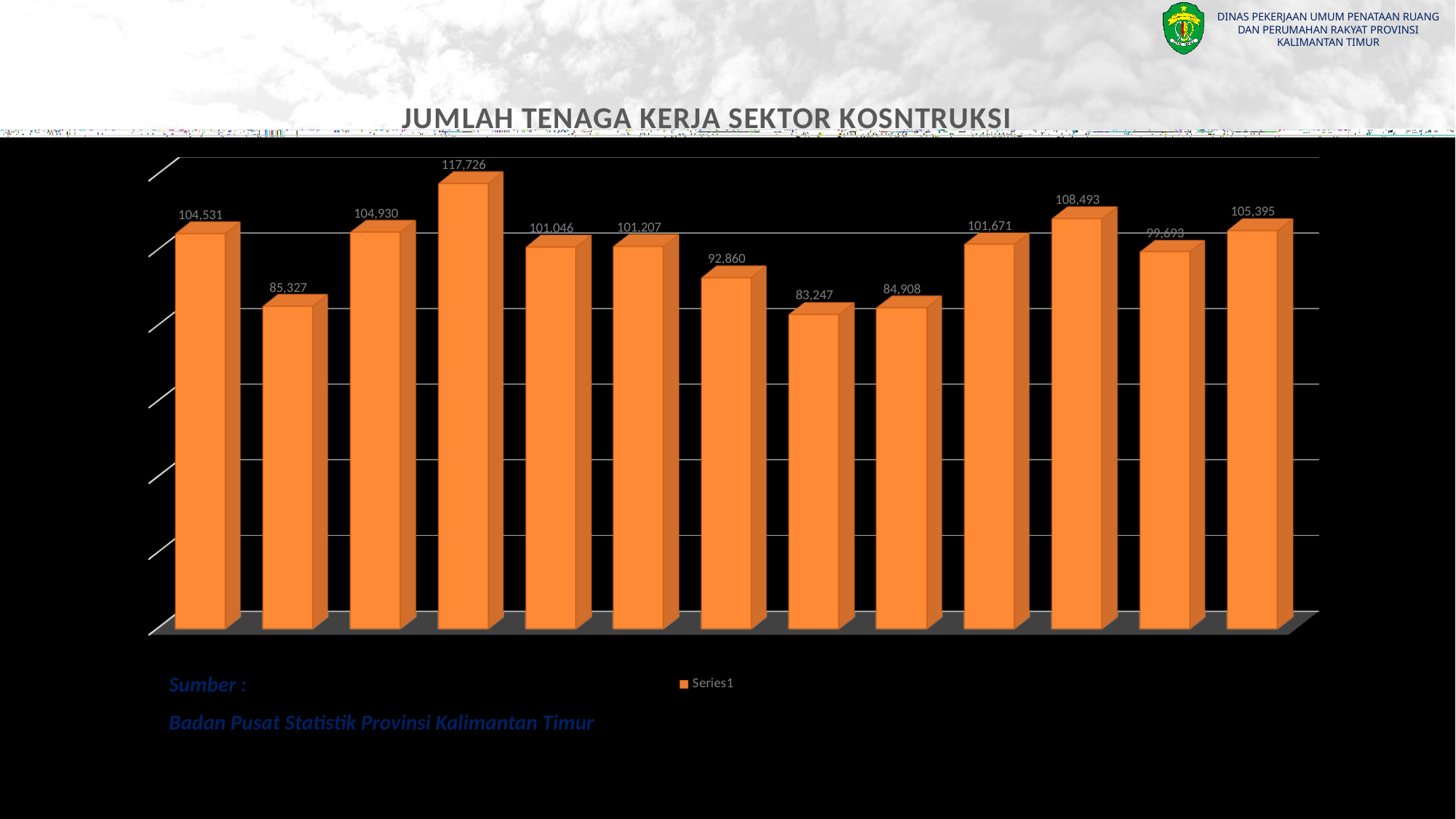
What is the title of the chart? JUMLAH TENAGA KERJA SEKTOR KOSNTRUKSI How many series does the legend list? 1 What is the highest value shown in the chart? 117,726 What is the difference between the first bar (104,531) and the second bar (85,327)? 19,204 What is the value shown on the second bar from the left? 85,327 Which is larger: the eleventh bar (108,493) or the last bar (105,395)? the eleventh bar (108,493) What is the value shown on the last (rightmost) bar? 105,395 What is the lowest value shown in the chart? 83,247 What is the value shown on the first (leftmost) bar? 104,531 What type of chart is shown on the slide? bar chart How many bars are plotted in the chart? 13 What is the difference between the highest value (117,726) and the lowest value (83,247)? 34,479